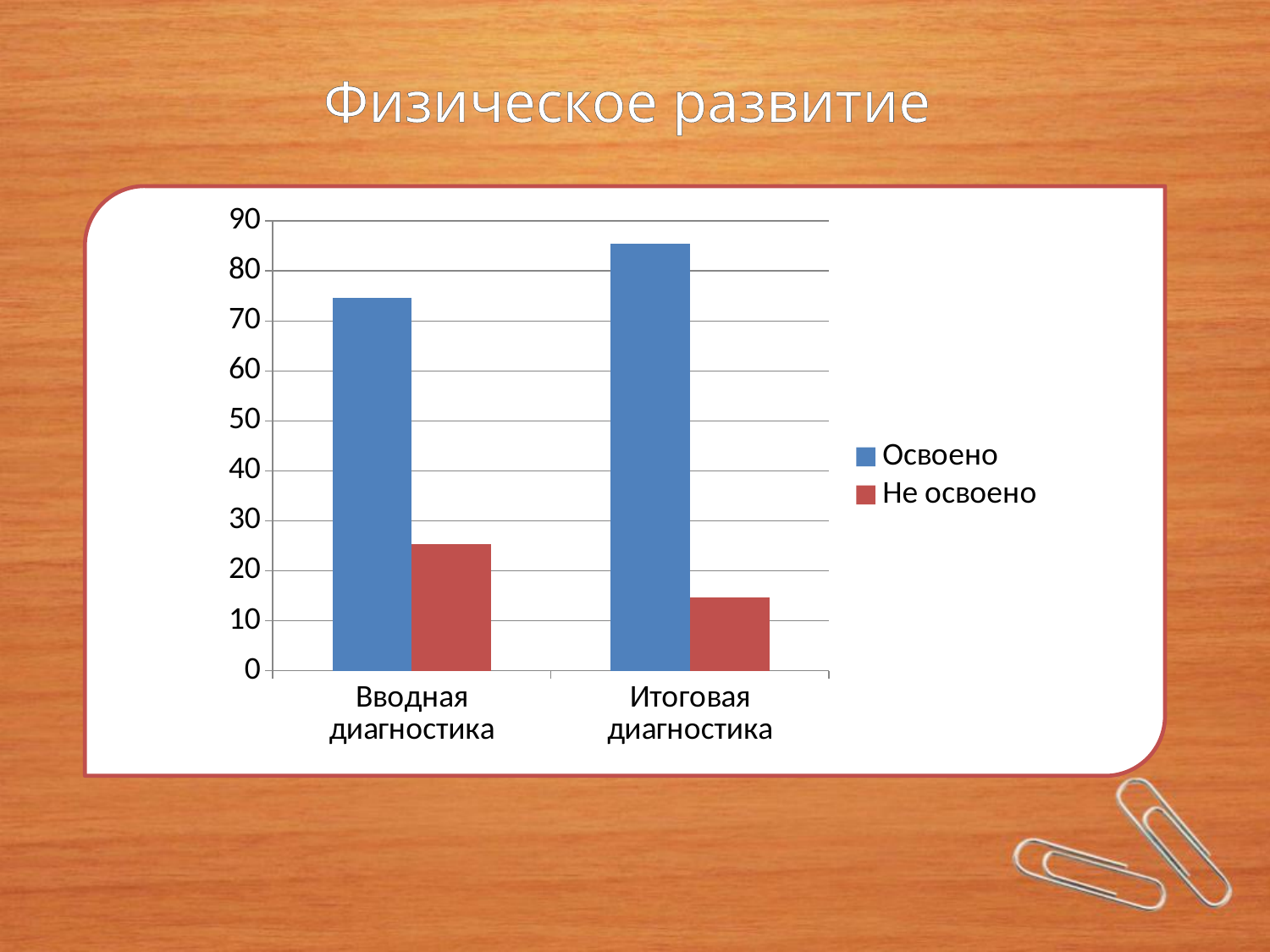
Is the value for Освоено at Итоговая диагностика greater or less than 80? greater Is the value for Не освоено at Итоговая диагностика greater or less than 20? less Is the value for Не освоено at Вводная диагностика greater or less than 20? greater Which bar is the lowest in the chart? Не освоено at Итоговая диагностика What is the title of the slide containing the chart? Физическое развитие How many series does the legend list? 2 Which category has the higher value for Освоено: Вводная диагностика or Итоговая диагностика? Итоговая диагностика Does the value for Не освоено rise or fall from Вводная диагностика to Итоговая диагностика? fall How many categories are shown on the x axis? 2 What kind of chart is shown on the slide? bar chart Which series is shown in blue? Освоено